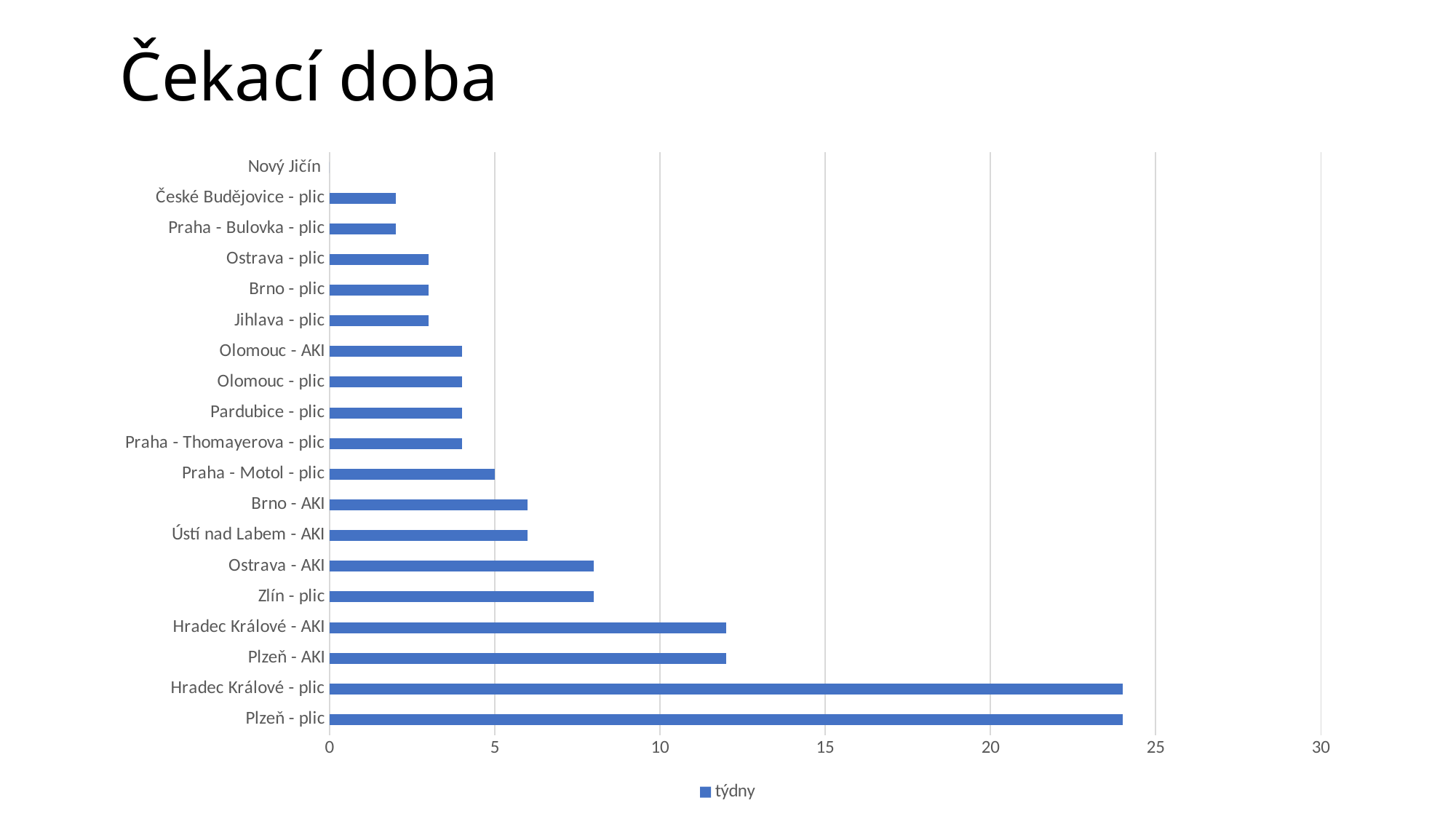
Is the value for České Budějovice - plic greater or less than 5? less How many series does the legend list? 1 Which has the larger value, Ostrava - AKI or Brno - AKI? Ostrava - AKI Is the value for Hradec Králové - plic greater or less than 20? greater How many categories are plotted on the chart? 19 What is the value for Praha - Motol - plic? 5 Is the value for Plzeň - AKI greater or less than 10? greater What kind of chart is shown on the slide? bar chart Which has the larger value, Zlín - plic or Hradec Králové - AKI? Hradec Králové - AKI What is the title of the slide containing the chart? Čekací doba What is the name of the series shown in the legend? týdny Which category has the lowest value? Nový Jičín